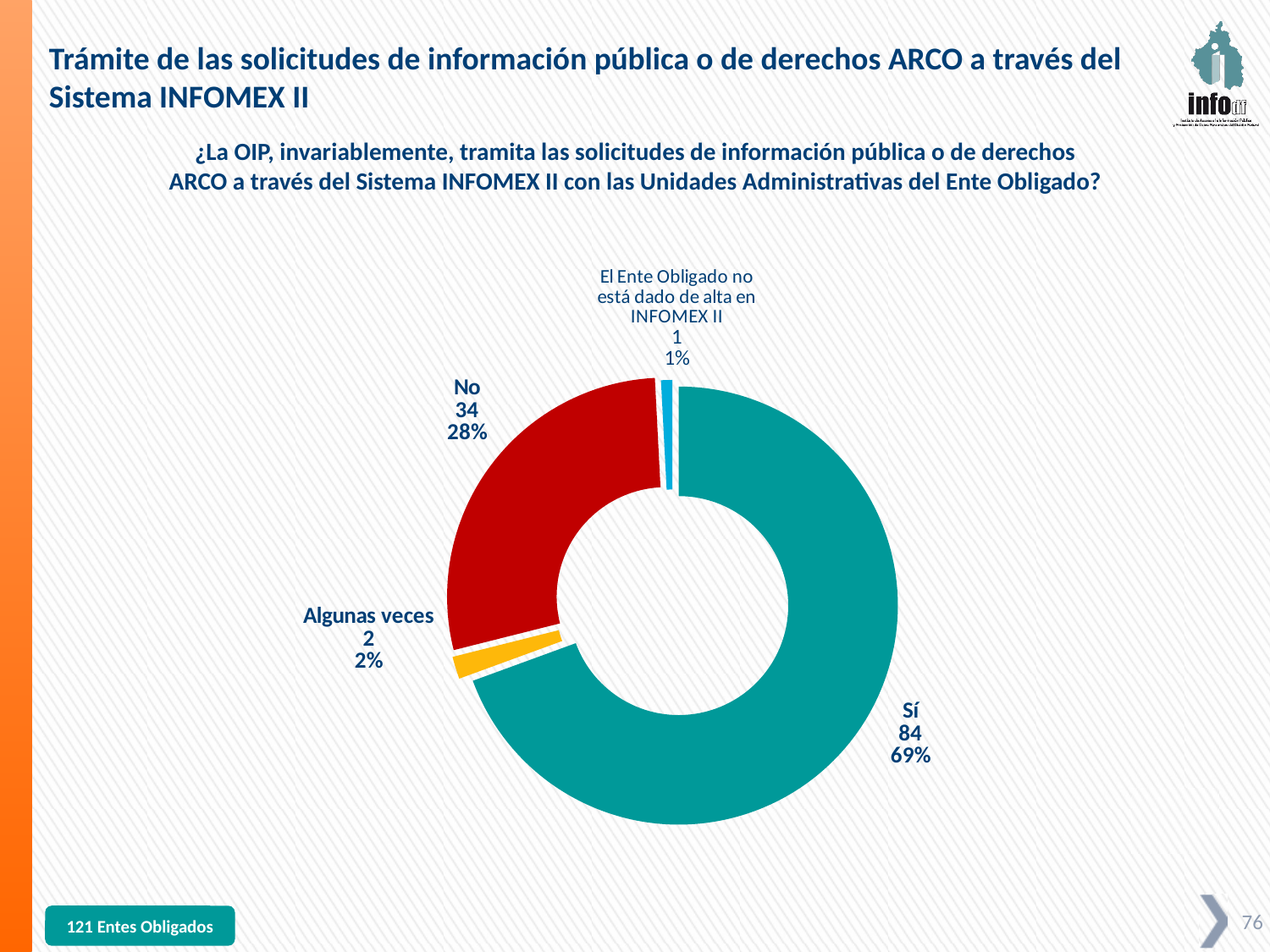
What percentage of the chart does "Sí" represent? 69% Which category has the largest share of the chart? Sí What colour is the "No" slice? Red Which is larger, the count for "No" or the count for "Algunas veces"? No How many entities answered "Sí"? 84 How many categories does the chart show? 4 What kind of chart is shown on the slide? Pie chart (doughnut) How many entities answered "Algunas veces"? 2 What percentage of the chart does "No" represent? 28% Which category has the smallest share of the chart? El Ente Obligado no está dado de alta en INFOMEX II What is the count for "El Ente Obligado no está dado de alta en INFOMEX II"? 1 What is the difference between the counts for "Sí" and "No"? 50